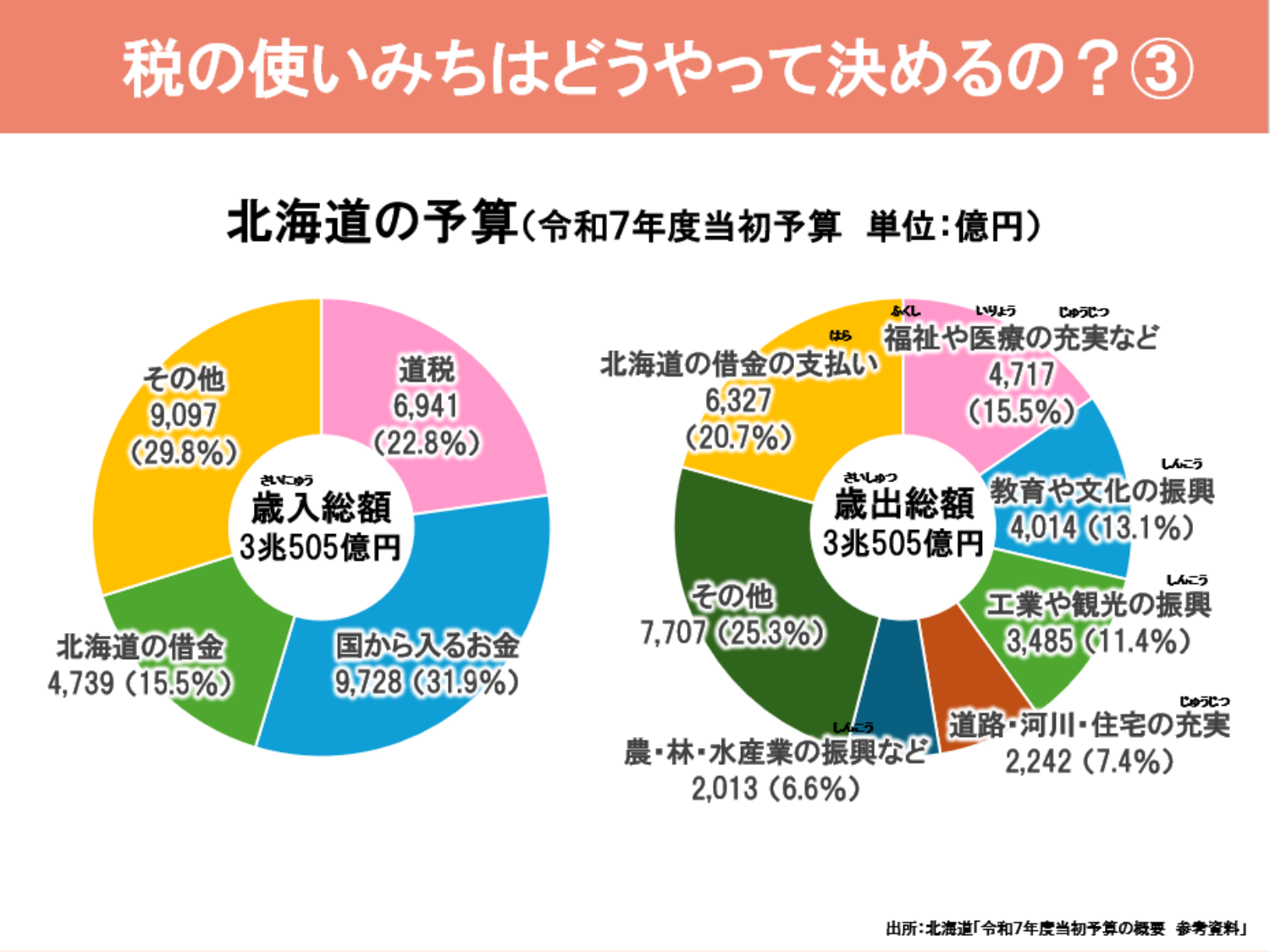
In the left chart (歳入総額), which category has the largest value? 国から入るお金 In the left chart (歳入総額), what is the value for 国から入るお金? 9,728 In the left chart (歳入総額), how many categories are shown? 4 In the right chart (歳出総額), which is larger, 教育や文化の振興 or 工業や観光の振興? 教育や文化の振興 In the left chart (歳入総額), what is the difference between 国から入るお金 and その他? 631 In the left chart (歳入総額), what share of the total does 道税 account for? 22.8% In the right chart (歳出総額), what share of the total does 北海道の借金の支払い account for? 20.7% In the right chart (歳出総額), how many categories are shown? 7 What kind of chart is used on this slide? Pie (donut) chart In the right chart (歳出総額), which category has the smallest value? 農・林・水産業の振興など In the right chart (歳出総額), what is the value for 福祉や医療の充実など? 4,717 In the left chart (歳入総額), which category has the smallest value? 北海道の借金